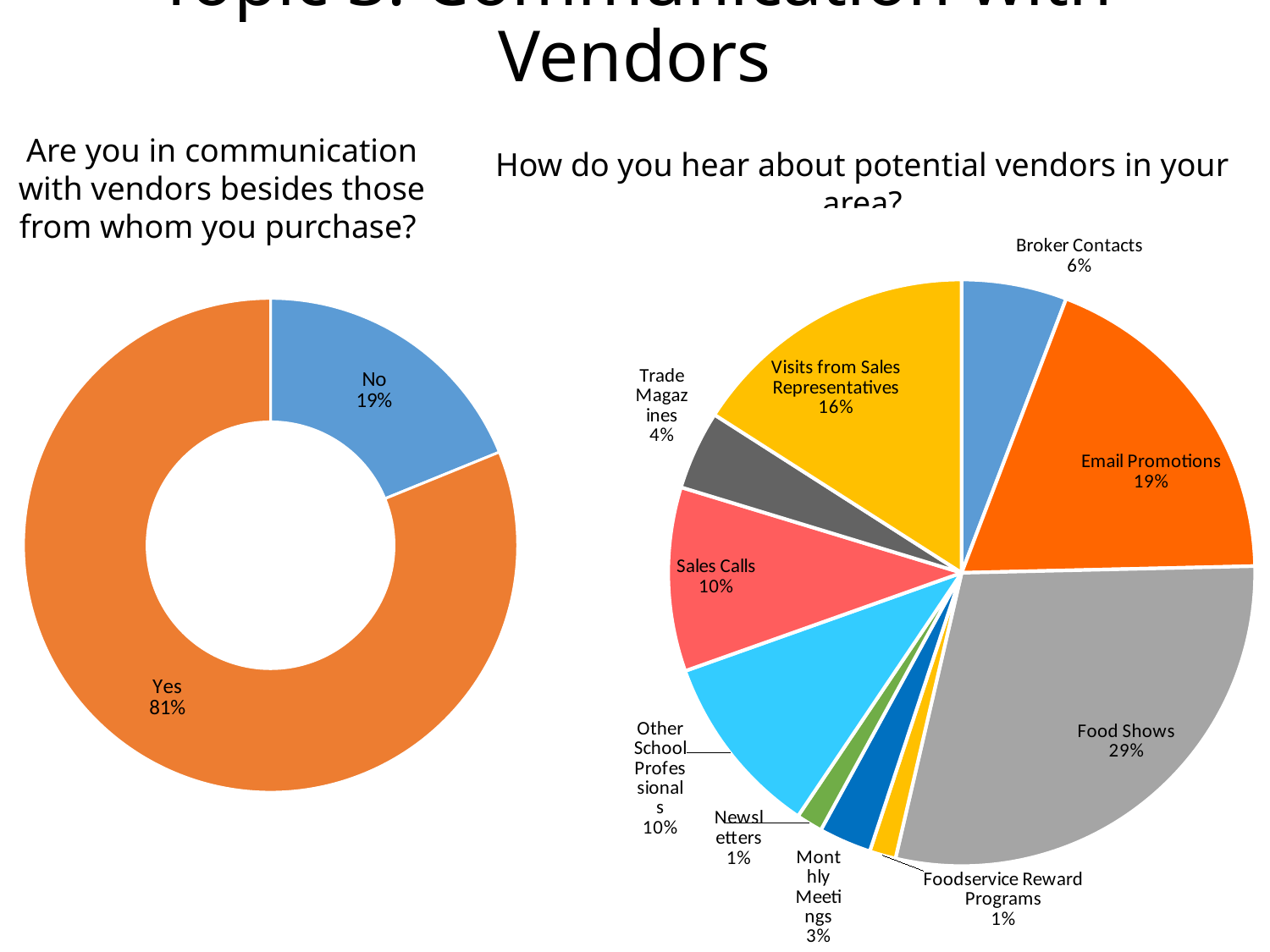
In the right chart, what share is attributed to Visits from Sales Representatives? 16% In the left chart, what is the difference between the Yes and No shares? 62% In the right chart, what share is attributed to Email Promotions? 19% In the right chart on how respondents hear about potential vendors, which category has the largest share? Food Shows In the right chart, what share is attributed to Broker Contacts? 6% In the right chart, which is larger: Sales Calls or Trade Magazines? Sales Calls In the left chart, what share of respondents answered Yes to being in communication with vendors besides those from whom they purchase? 81% In the right chart, what is the difference between the Food Shows share and the Email Promotions share? 10% In the left chart, what share of respondents answered No? 19% What kind of chart is the right chart about how respondents hear about potential vendors? Pie chart What kind of chart is the left chart about communication with vendors? Doughnut chart In the right chart, how many categories are shown? 10